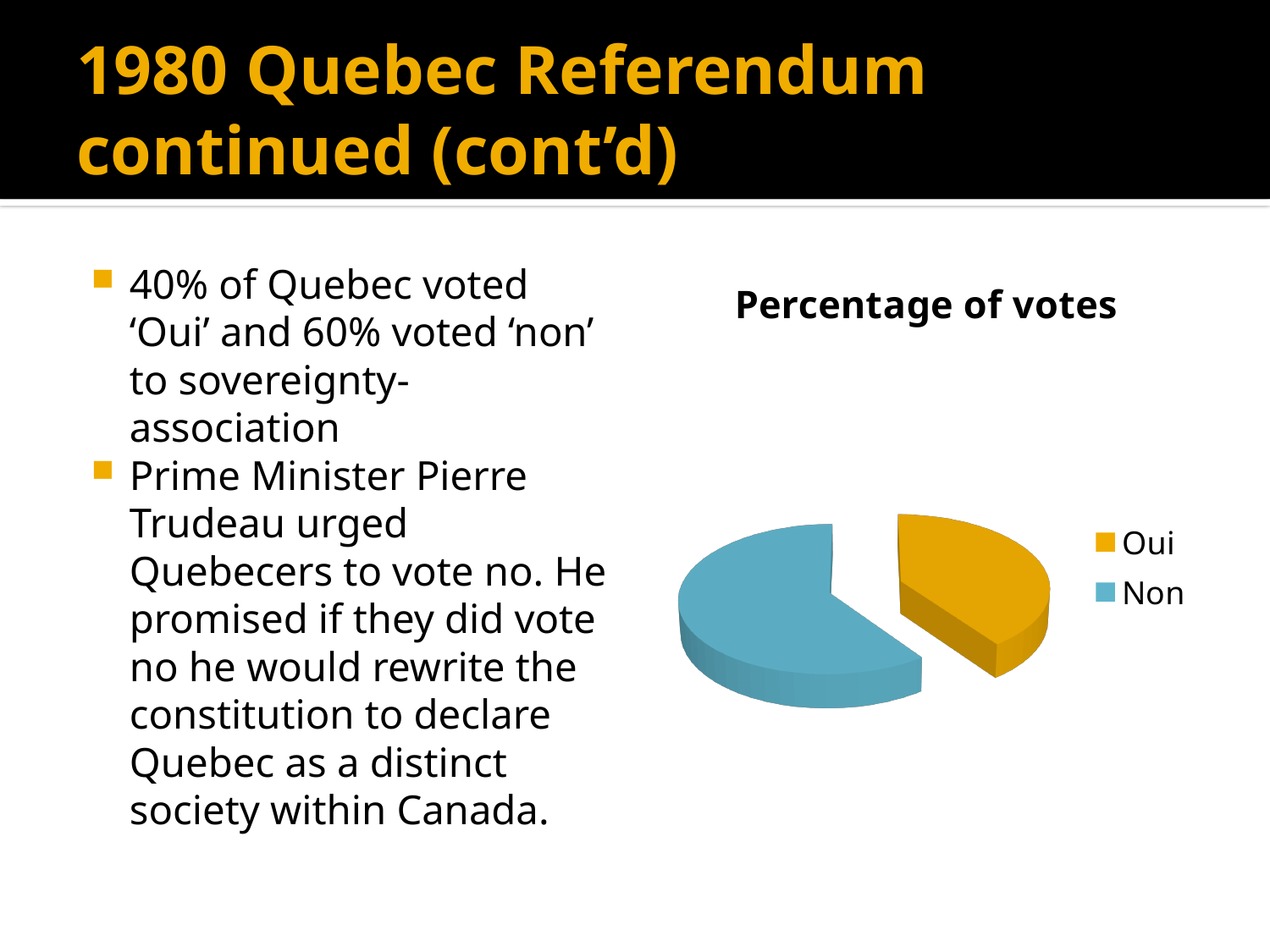
Does the Non slice take up more or less than half of the pie? more How many slices does the pie chart have? 2 What kind of chart is shown on the slide? pie chart Which slice of the pie chart is the smallest? Oui What colour is the Oui slice in the pie chart? gold Which slice of the pie chart is the largest? Non Which is larger in the pie chart, the Oui slice or the Non slice? Non How many entries does the chart legend list? 2 What is the title of the chart? Percentage of votes